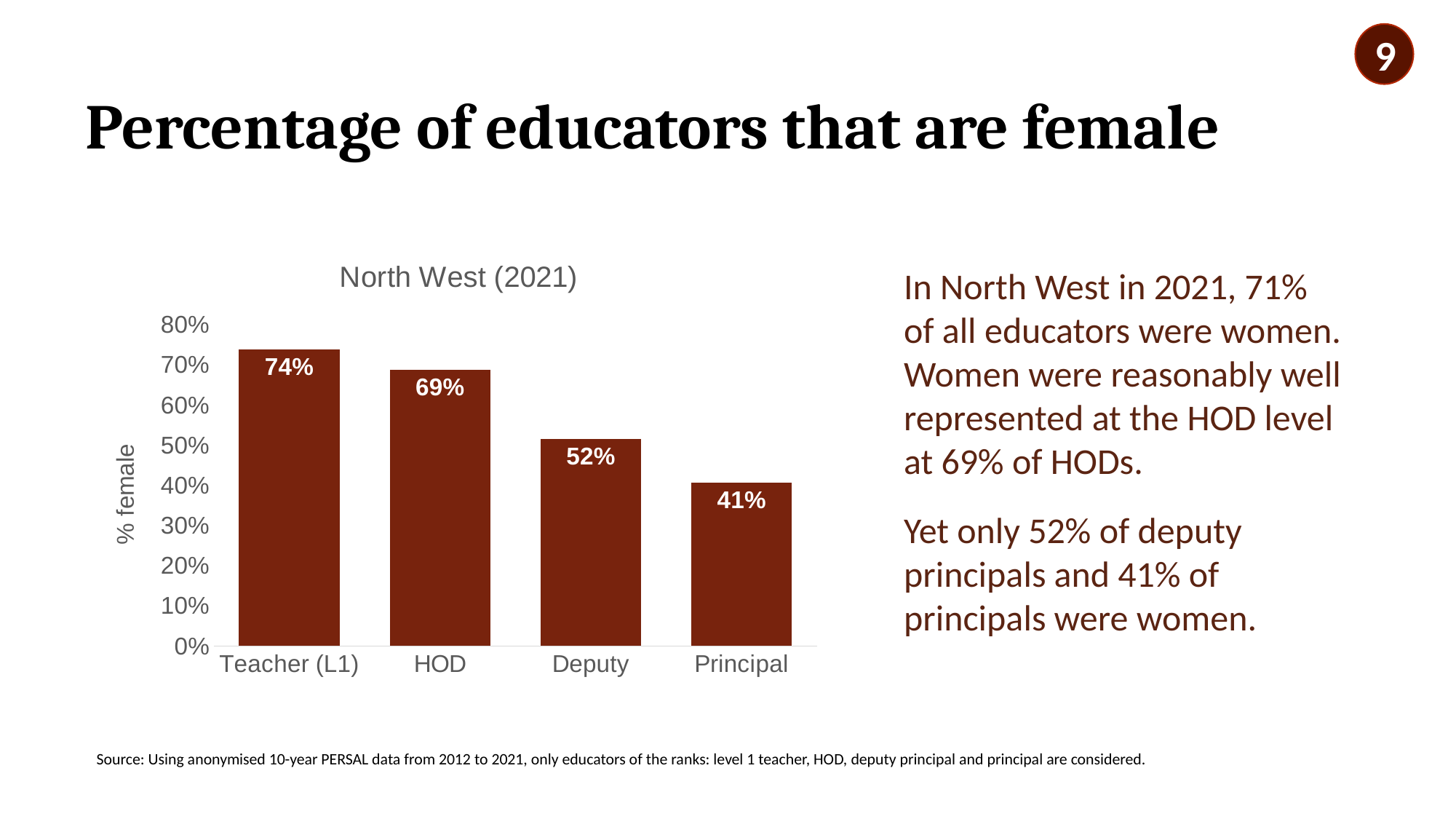
What is the difference between the HOD value and the Deputy value? 17% Do the values rise or fall moving from Teacher (L1) to Principal along the x axis? Fall What percentage of Teacher (L1) educators are female in the North West (2021) chart? 74% Which category has the highest percentage of female educators? Teacher (L1) What is the difference between the Teacher (L1) value and the Principal value? 33% What is the value shown for Deputy in the chart? 52% Which is larger, the value for HOD or the value for Deputy? HOD What is the value shown for Principal in the chart? 41% How many categories are shown on the x axis of the chart? 4 What is the value shown for HOD in the chart? 69% What kind of chart is shown on the slide? Bar chart Which category has the lowest percentage of female educators? Principal